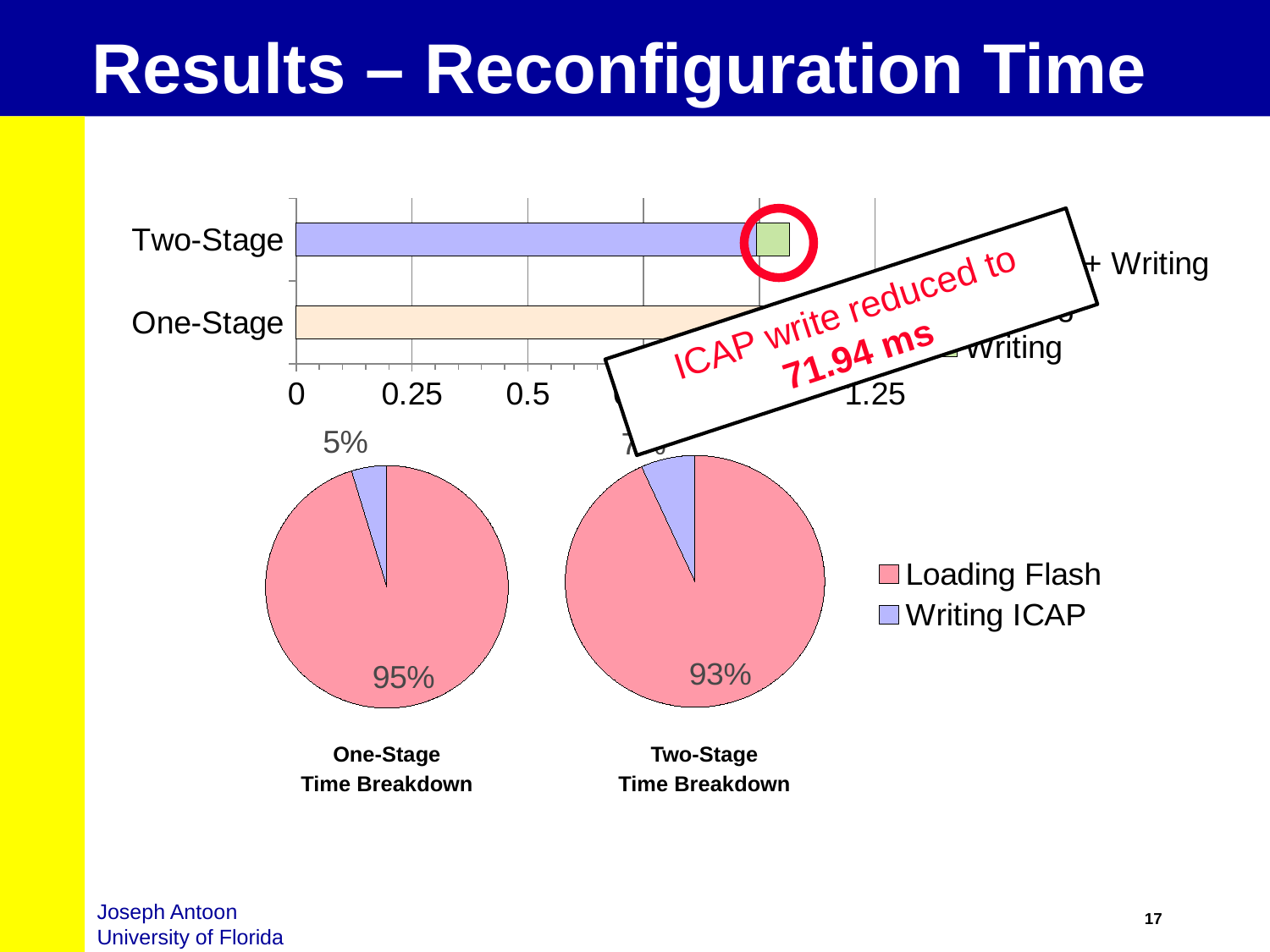
In the One-Stage Time Breakdown pie chart, what share is Loading Flash? 95% What does the red-bordered callout on the slide say the ICAP write was reduced to? 71.94 ms In the top bar chart, is the total length of the Two-Stage bar greater or less than 1.25? less What kind of charts are the One-Stage Time Breakdown and Two-Stage Time Breakdown charts? pie charts What is the difference between the Loading Flash share in the One-Stage Time Breakdown pie and the Two-Stage Time Breakdown pie? 2 percentage points In the One-Stage Time Breakdown pie chart, what share is Writing ICAP? 5% How many series does the legend of the pie charts list? 2 In the Two-Stage Time Breakdown pie chart, what share is Loading Flash? 93% How many categories does the top bar chart show? 2 Which pie chart shows a larger Loading Flash share, One-Stage Time Breakdown or Two-Stage Time Breakdown? One-Stage Time Breakdown What kind of chart is the top chart comparing Two-Stage and One-Stage? bar chart